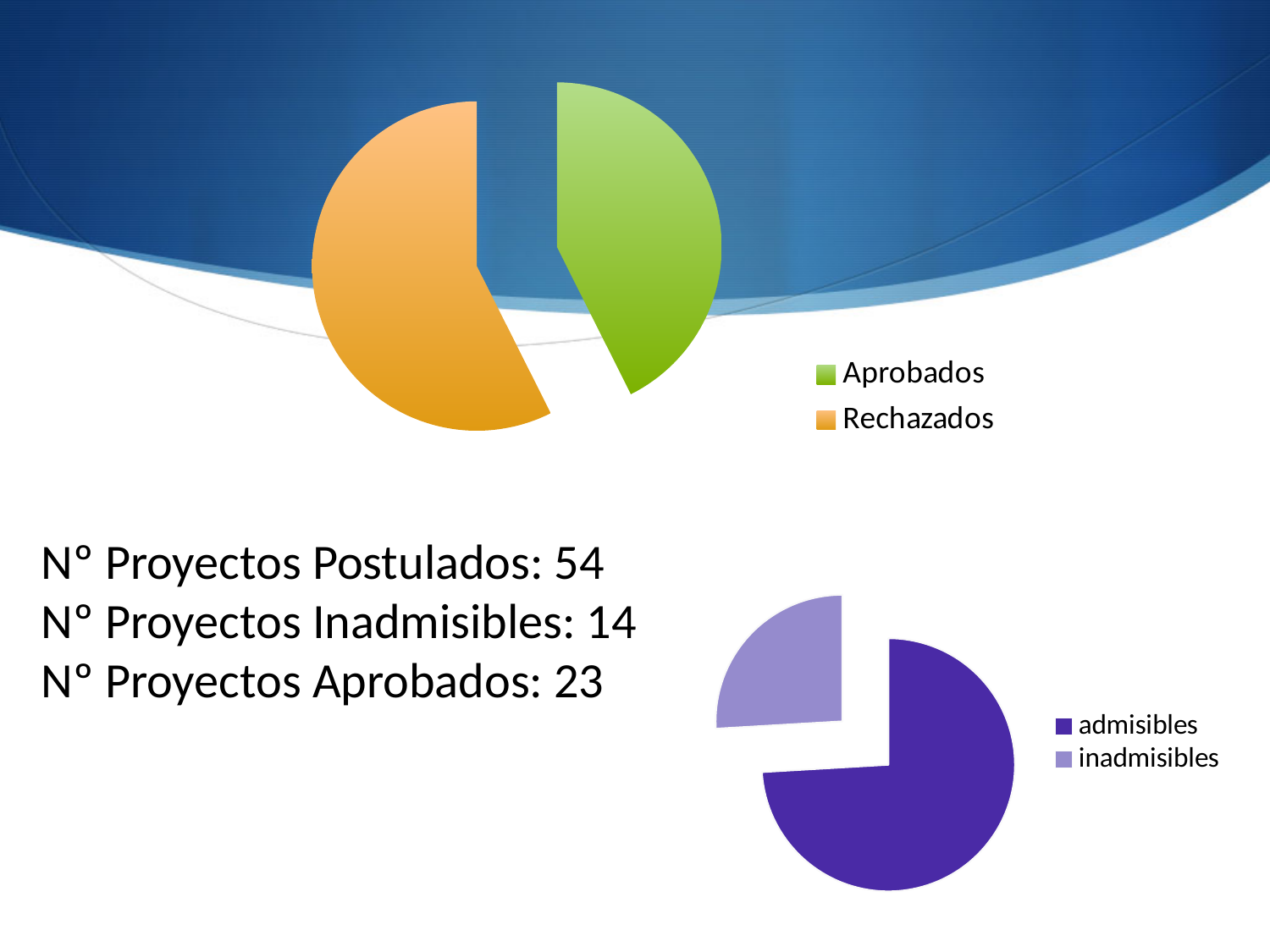
In the bottom right pie chart, which category has the smaller slice? inadmisibles In the top pie chart, is the slice for Aprobados larger or smaller than the slice for Rechazados? smaller How many entries does the legend of the bottom right pie chart list? 2 In the top pie chart, which category has the smaller slice? Aprobados In the bottom right pie chart, which category has the larger slice? admisibles How many slices does the top pie chart have? 2 What kind of chart is the chart at the top of the slide? pie chart What are the two legend entries of the bottom right pie chart? admisibles and inadmisibles In the top pie chart, which category has the larger slice? Rechazados What kind of chart is the chart at the bottom right of the slide? pie chart In the top pie chart, what colour is the Aprobados slice? green In the bottom right pie chart, is the slice for admisibles larger or smaller than the slice for inadmisibles? larger